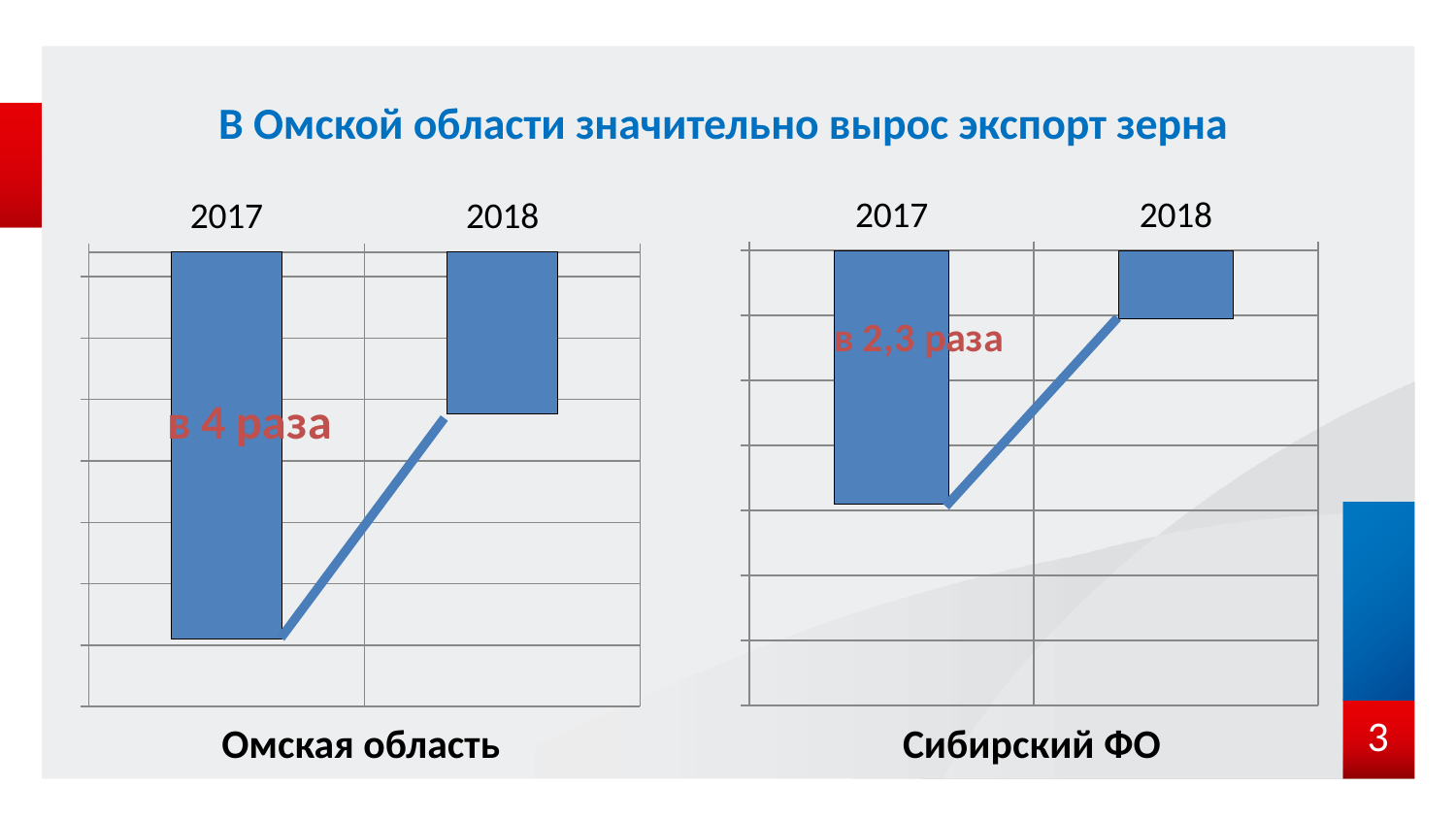
Which chart shows the larger growth factor, "Омская область" or "Сибирский ФО"? Омская область What kind of chart is the "Омская область" chart? bar chart Which two years are compared on the "Омская область" chart? 2017 and 2018 What kind of chart is the "Сибирский ФО" chart? bar chart On the "Омская область" chart, by what factor does the label say grain export grew? в 4 раза How many categories (years) are shown on the "Омская область" chart? 2 How many categories (years) are shown on the "Сибирский ФО" chart? 2 How many charts are on the slide? 2 What is the title of the chart on the right side of the slide? Сибирский ФО On the "Сибирский ФО" chart, by what factor does the label say grain export grew? в 2,3 раза